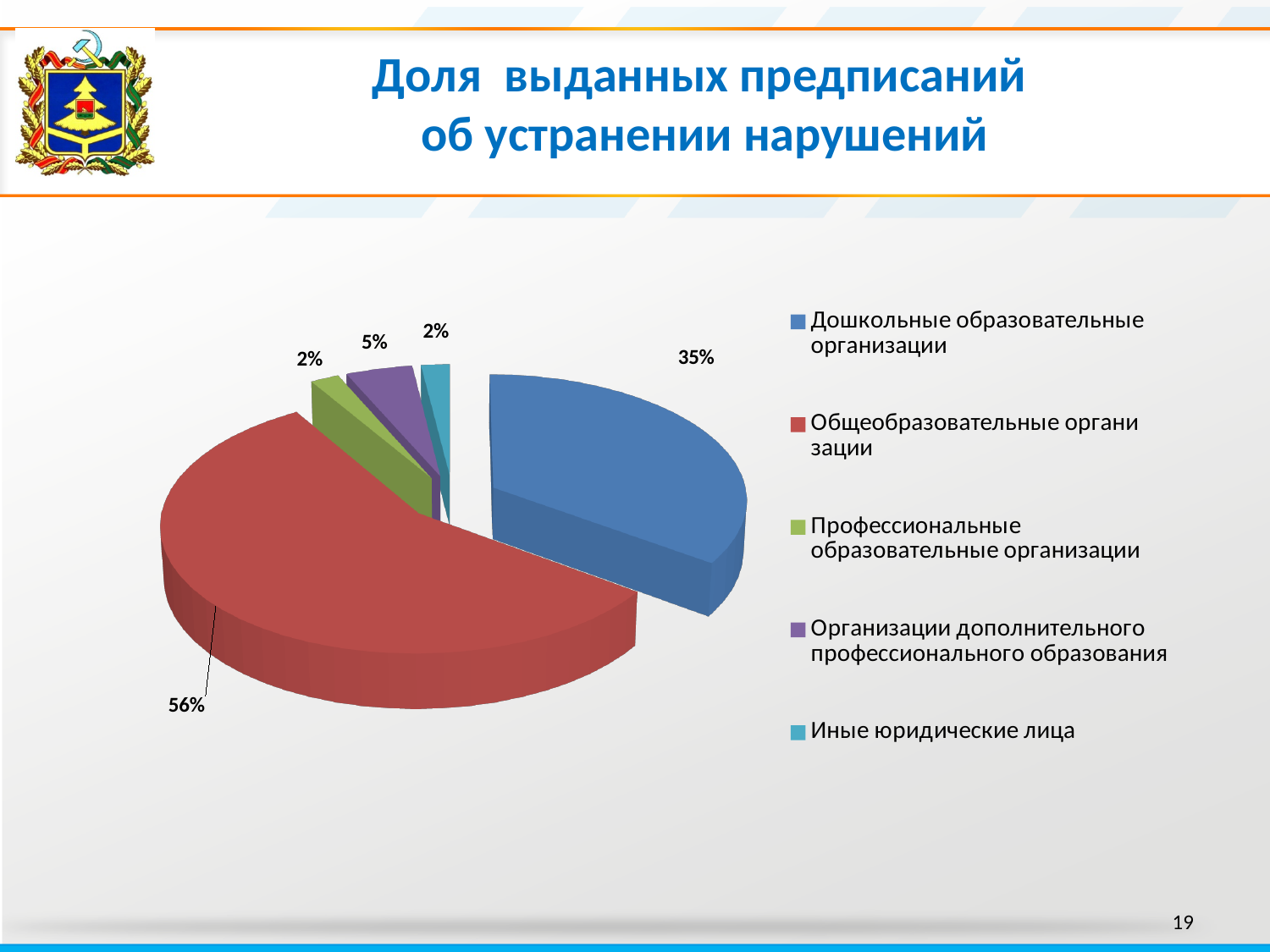
What share of the pie is labelled for Иные юридические лица? 2% Which slice is larger: Организации дополнительного профессионального образования or Иные юридические лица? Организации дополнительного профессионального образования What share of the pie is labelled for Организации дополнительного профессионального образования? 5% What colour is the slice for Дошкольные образовательные организации? blue What kind of chart is shown on the slide? pie chart How many entries does the legend list? 5 What share of the pie is labelled for Профессиональные образовательные организации? 2% What share of the pie is labelled for Общеобразовательные организации? 56% How many slices does the pie chart have? 5 Which category has the largest slice of the pie? Общеобразовательные организации What share of the pie is labelled for Дошкольные образовательные организации? 35% What is the difference in percentage points between the slices for Общеобразовательные организации and Дошкольные образовательные организации? 21